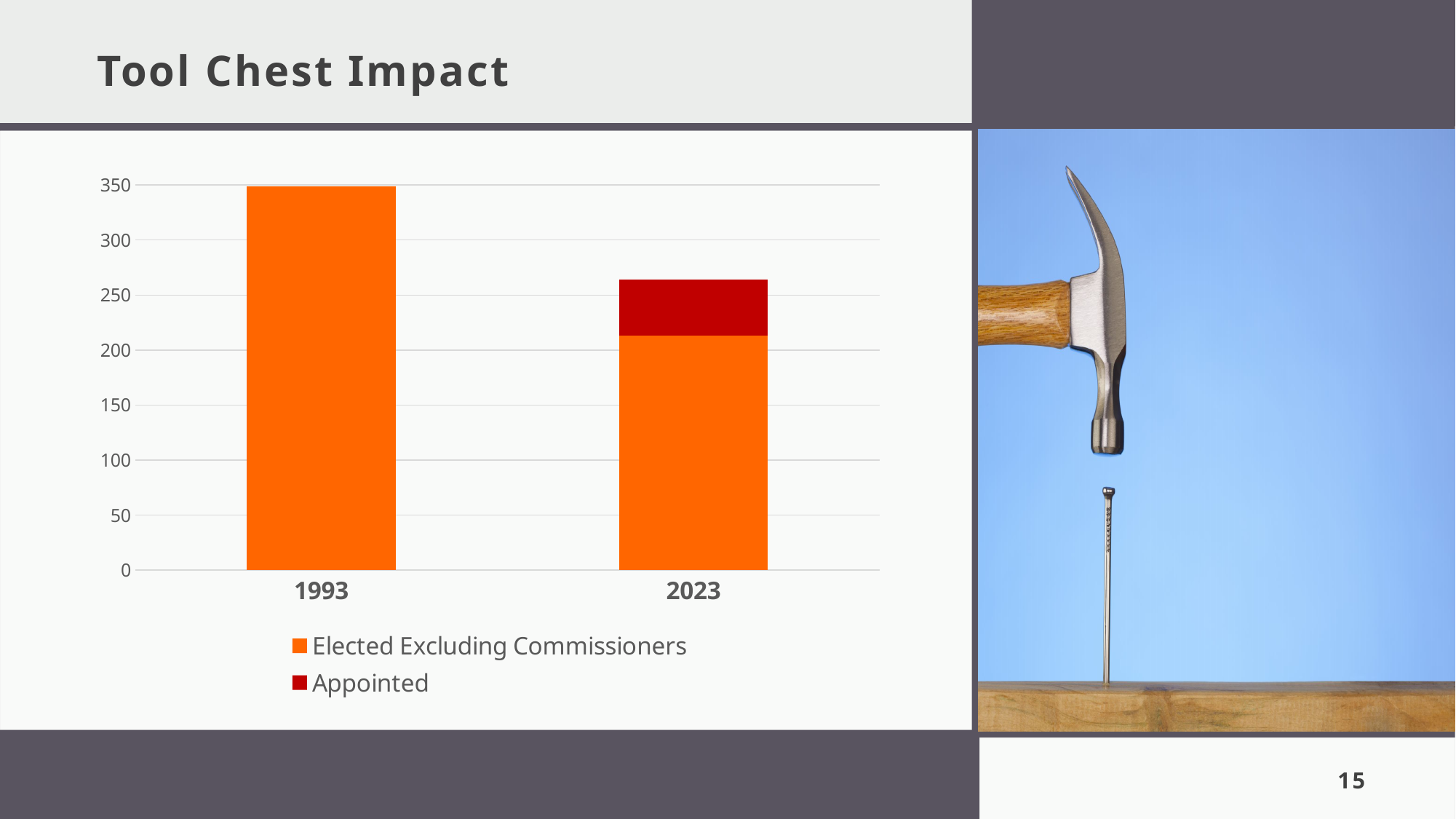
Is the value for Elected Excluding Commissioners in 2023 greater or less than 250? less Which year has the taller bar in the chart? 1993 Does the Elected Excluding Commissioners value rise or fall from 1993 to 2023? fall Is the Appointed value in 2023 greater or less than 100? less Is the total height of the 2023 bar greater or less than 300? less What kind of chart is shown on the slide? Stacked bar chart How many series does the chart's legend list? 2 Which year has the shorter bar in the chart? 2023 How many categories are shown on the x axis of the chart? 2 Which year's bar includes an Appointed segment? 2023 Which is larger: the Elected Excluding Commissioners value for 1993 or for 2023? 1993